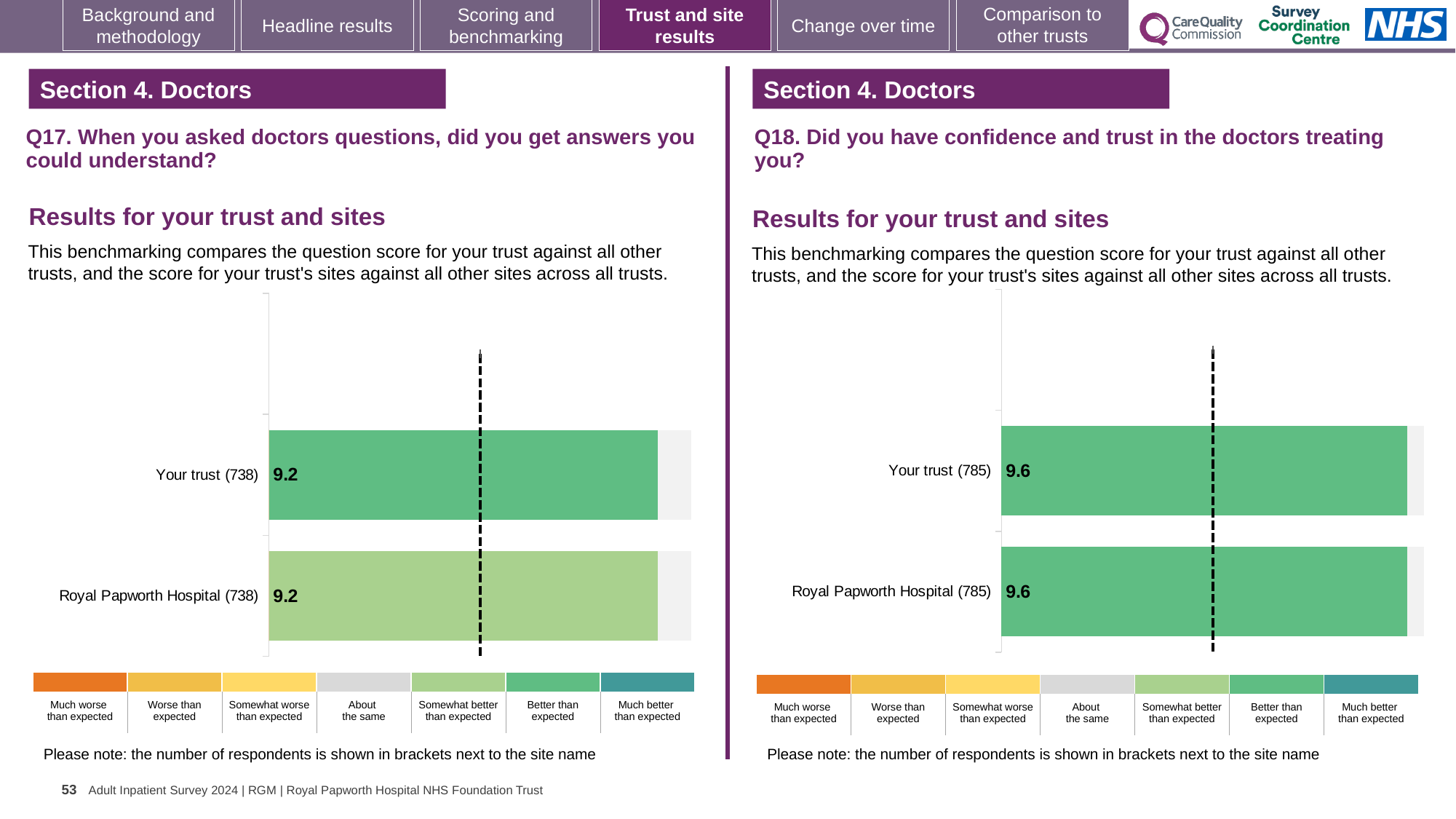
How many bars are plotted on the Q17 chart (left)? 2 On the Q18 chart (right), what is the difference between the score for Your trust and the score for Royal Papworth Hospital? 0 On the Q17 chart (left), what is the score for Your trust (738)? 9.2 How many respondents are shown in brackets for Your trust on the Q17 chart (left)? 738 On the Q17 chart (left), what is the difference between the score for Your trust and the score for Royal Papworth Hospital? 0 On the Q18 chart (right), what is the score for Your trust (785)? 9.6 On the Q18 chart (right), which benchmark category does the colour of the Your trust bar correspond to in the legend? Better than expected How many bars are plotted on the Q18 chart (right)? 2 What type of chart is used on the Q18 chart (right)? Bar chart On the Q17 chart (left), what is the score for Royal Papworth Hospital (738)? 9.2 On the Q17 chart (left), which benchmark category does the colour of the Royal Papworth Hospital bar correspond to in the legend? Somewhat better than expected On the Q18 chart (right), what is the score for Royal Papworth Hospital (785)? 9.6